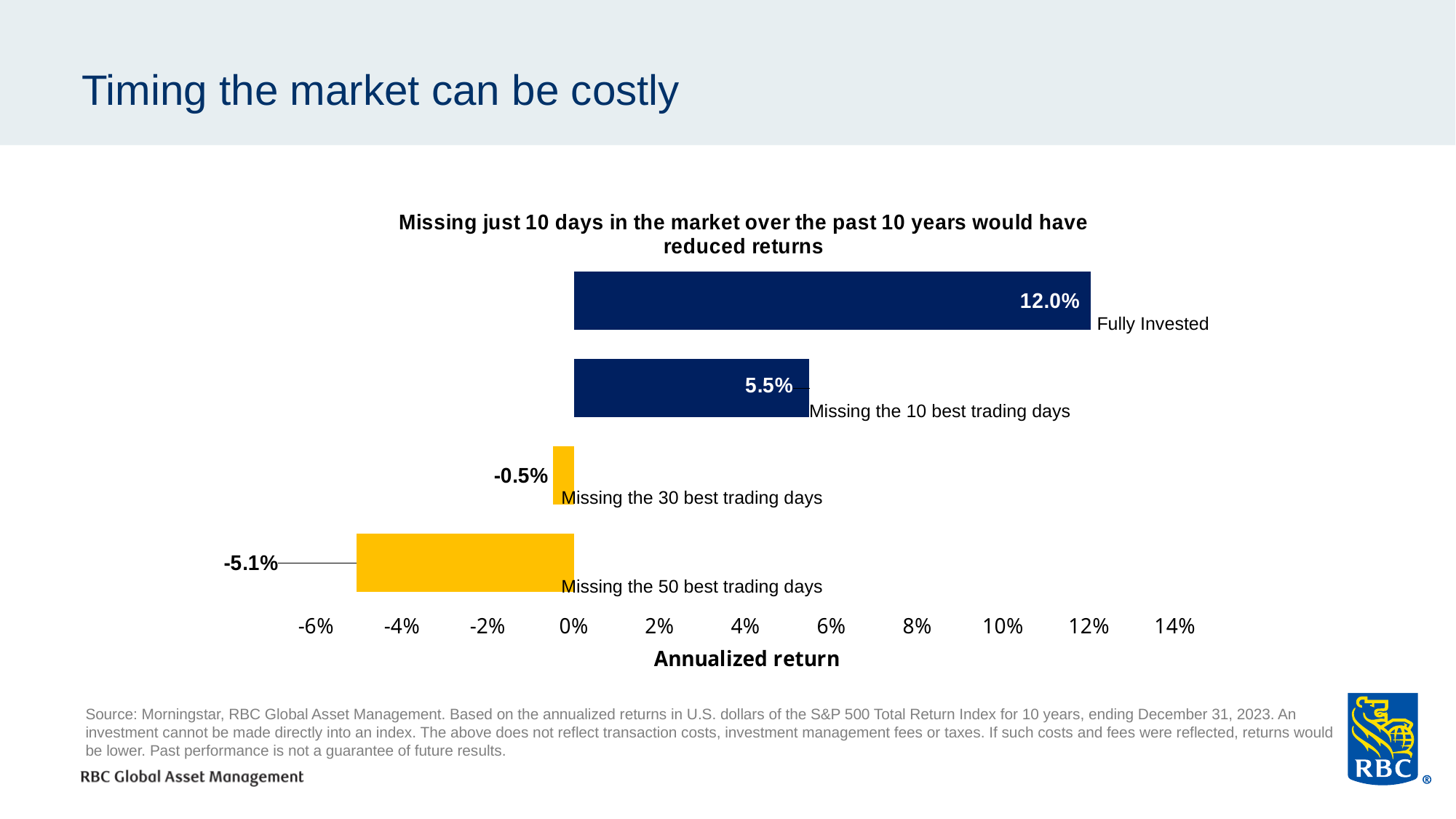
What is the difference in annualized return between Fully Invested and Missing the 10 best trading days? 6.5% What is the annualized return when missing the 30 best trading days? -0.5% What is the annualized return when missing the 10 best trading days? 5.5% How many categories are shown in the chart? 4 What is the title of the chart? Missing just 10 days in the market over the past 10 years would have reduced returns What is the label of the horizontal axis? Annualized return What is the annualized return for Fully Invested? 12.0% Which category has the lowest annualized return? Missing the 50 best trading days What is the annualized return when missing the 50 best trading days? -5.1% Which has a higher annualized return: Missing the 30 best trading days or Missing the 50 best trading days? Missing the 30 best trading days Which category has the highest annualized return? Fully Invested What kind of chart is shown on the slide? Bar chart